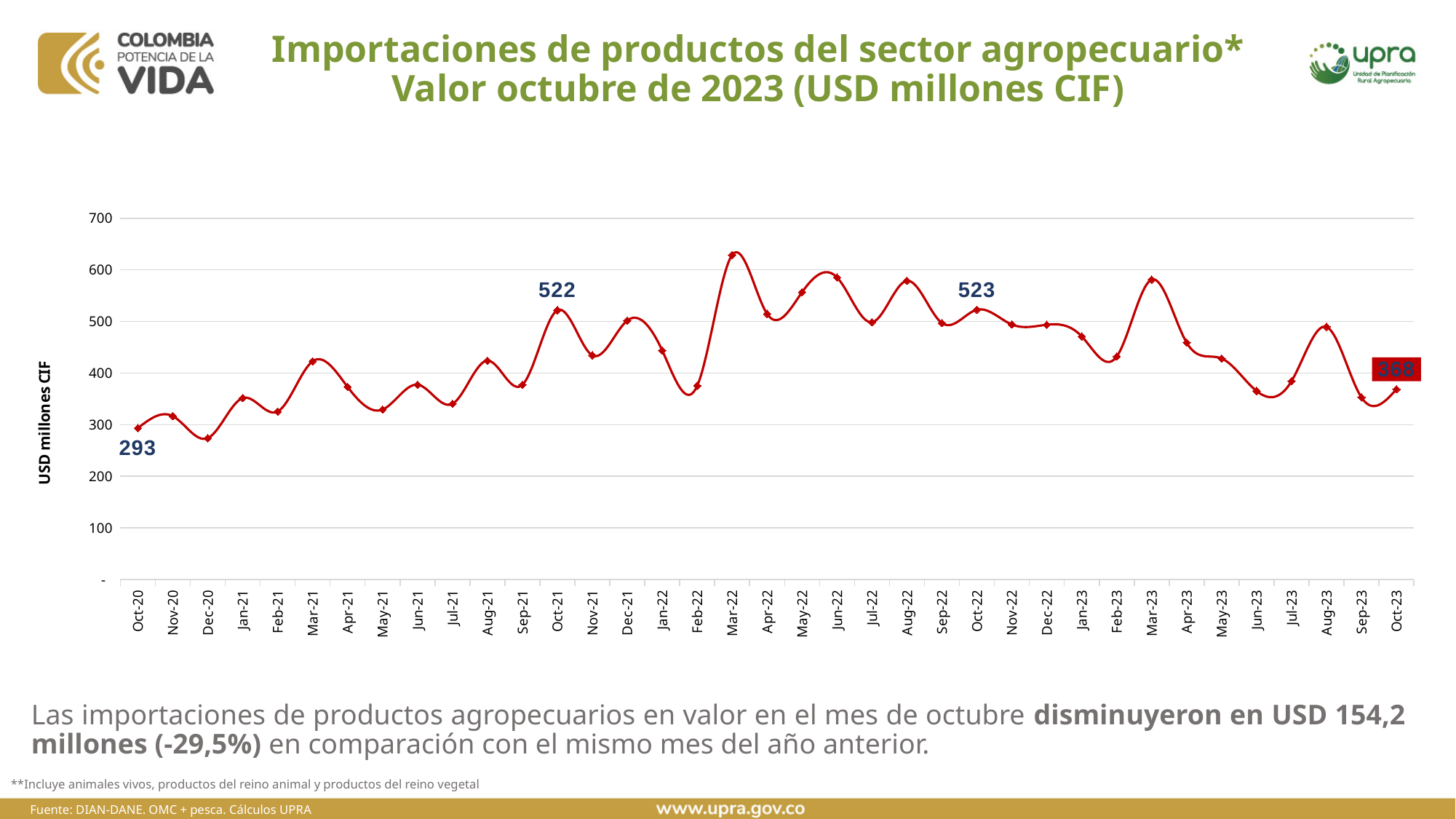
What kind of chart is shown on the slide? line chart What is the value for Oct-20? 293 Which month has the lowest value on the chart? Dec-20 What is the value for Oct-22? 523 Which month has the highest value on the chart? Mar-22 Which is larger, the value for Oct-20 or the value for Oct-23? Oct-23 Is the value for Mar-22 greater or less than 600? greater How many monthly data points are plotted on the chart? 37 What is the difference between the values for Oct-21 and Oct-20? 229 Is the value for Jun-23 greater or less than 400? less What is the value for Oct-21? 522 What is the value for Oct-23? 368